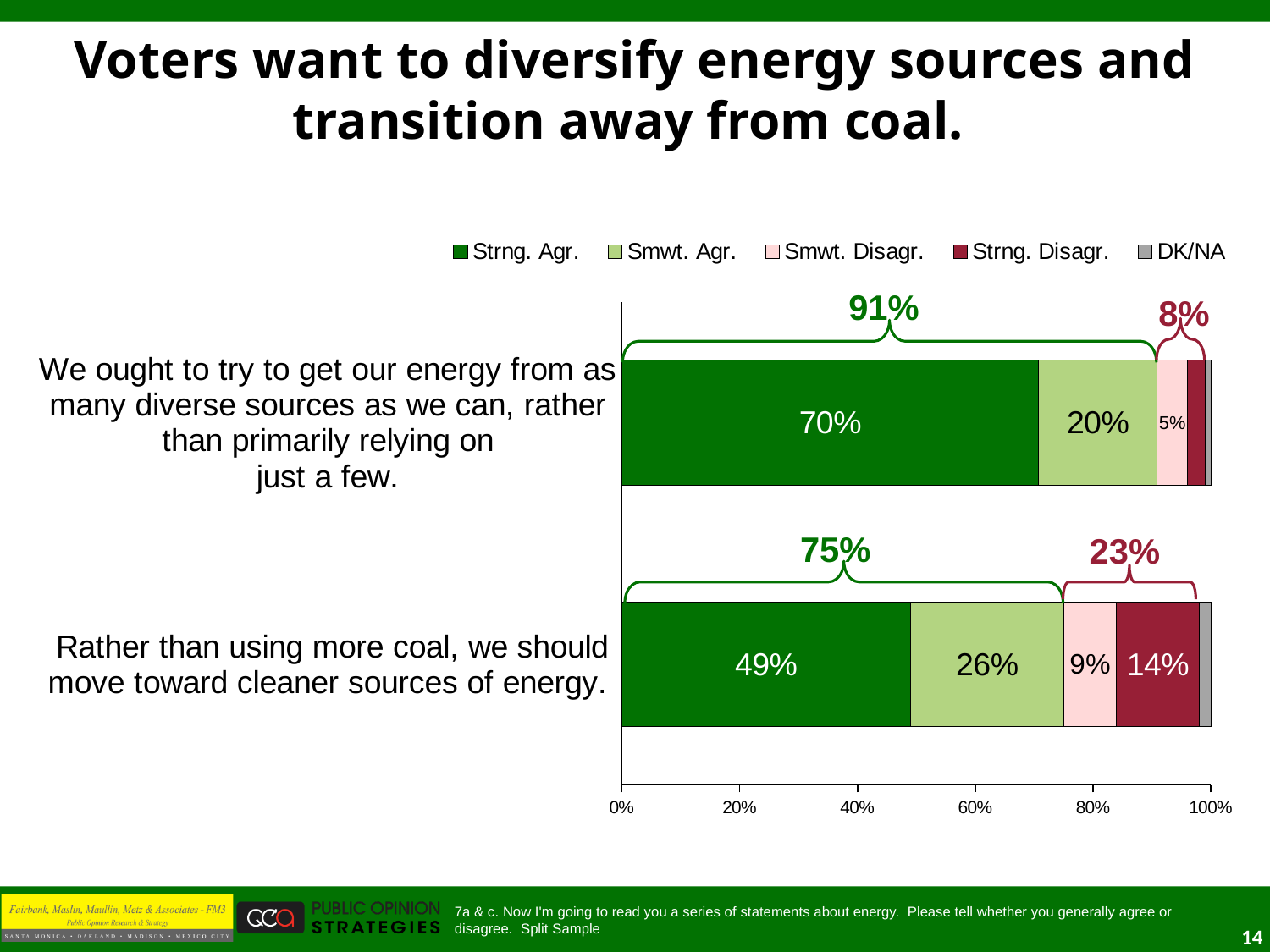
How many statements are plotted in the chart? 2 What is the difference between the strongly agree percentages for the two statements? 21 percentage points What percentage somewhat agree that rather than using more coal, we should move toward cleaner sources of energy? 26% What percentage strongly disagree with the statement about moving toward cleaner sources of energy rather than using more coal? 14% Which statement has the higher share of strong agreement? We ought to try to get our energy from as many diverse sources as we can What type of chart is shown on the slide? Stacked bar chart What percentage strongly agree that we ought to get our energy from as many diverse sources as we can? 70% What is the total disagreement shown for the statement about moving toward cleaner sources of energy rather than coal? 23% Is the somewhat disagree value for the diverse energy sources statement larger or smaller than the somewhat disagree value for the cleaner energy statement? smaller How many response categories does the legend list? 5 What is the total agreement (strongly plus somewhat agree) shown for the statement about getting energy from diverse sources? 91% What colour represents the Strng. Disagr. category in the legend? Dark red